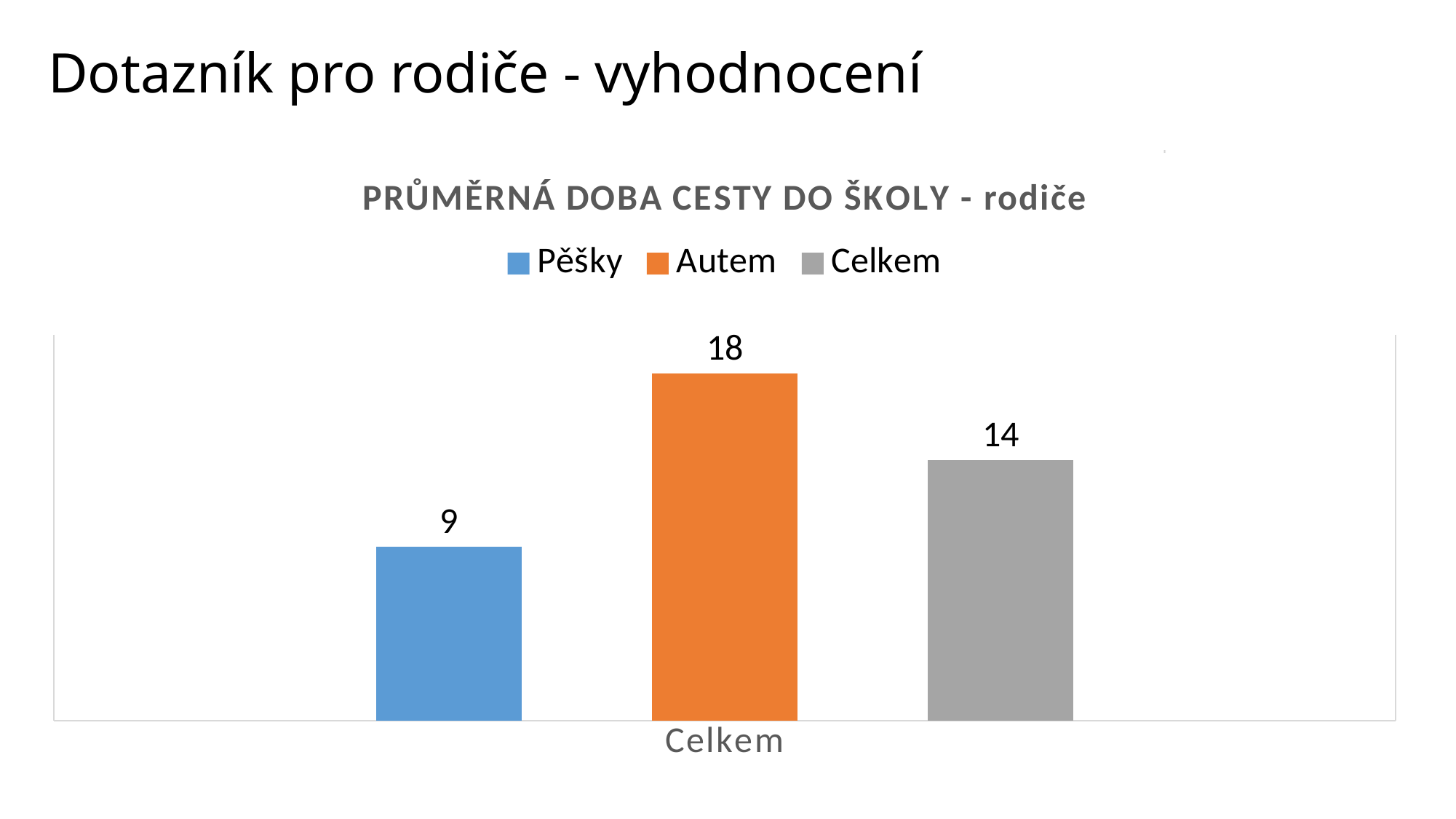
How many series does the legend list? 3 What is the value for Pěšky? 9 Which is larger, the value for Celkem or the value for Pěšky? Celkem What is the difference between the values for Autem and Pěšky? 9 What is the title of the chart? PRŮMĚRNÁ DOBA CESTY DO ŠKOLY - rodiče What is the value for Autem? 18 What kind of chart is shown on the slide? Bar chart What is the difference between the values for Autem and Celkem? 4 What is the value for Celkem? 14 What colour is the bar for Autem? Orange Which series has the lowest value? Pěšky Which series has the highest value? Autem